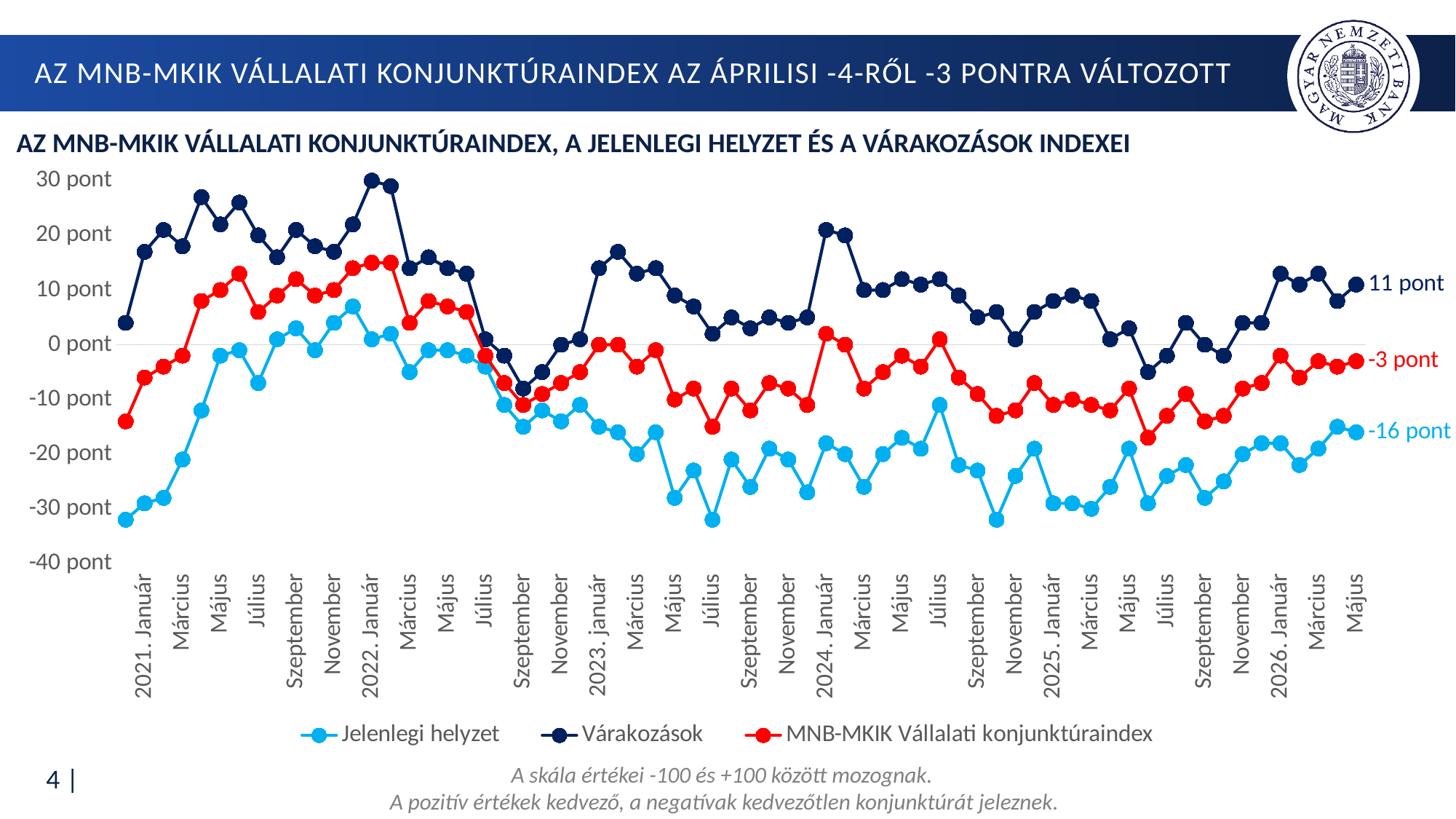
Which series has the lowest value at the final data point (2026 Május)? Jelenlegi helyzet What is the latest value shown for the Jelenlegi helyzet series? -16 pont What kind of chart is shown on the slide? line chart What is the latest value shown for the Várakozások series? 11 pont What is the latest value shown for the MNB-MKIK Vállalati konjunktúraindex series? -3 pont What is the difference between the latest Várakozások value and the latest Jelenlegi helyzet value? 27 pont Which series has the highest value at the final data point (2026 Május)? Várakozások Is the value of Várakozások in 2021 Március greater or less than 20 pont? less What is the difference between the latest Várakozások value and the latest MNB-MKIK Vállalati konjunktúraindex value? 14 pont How many series does the legend list? 3 At the last data point, which series is higher: Várakozások or Jelenlegi helyzet? Várakozások